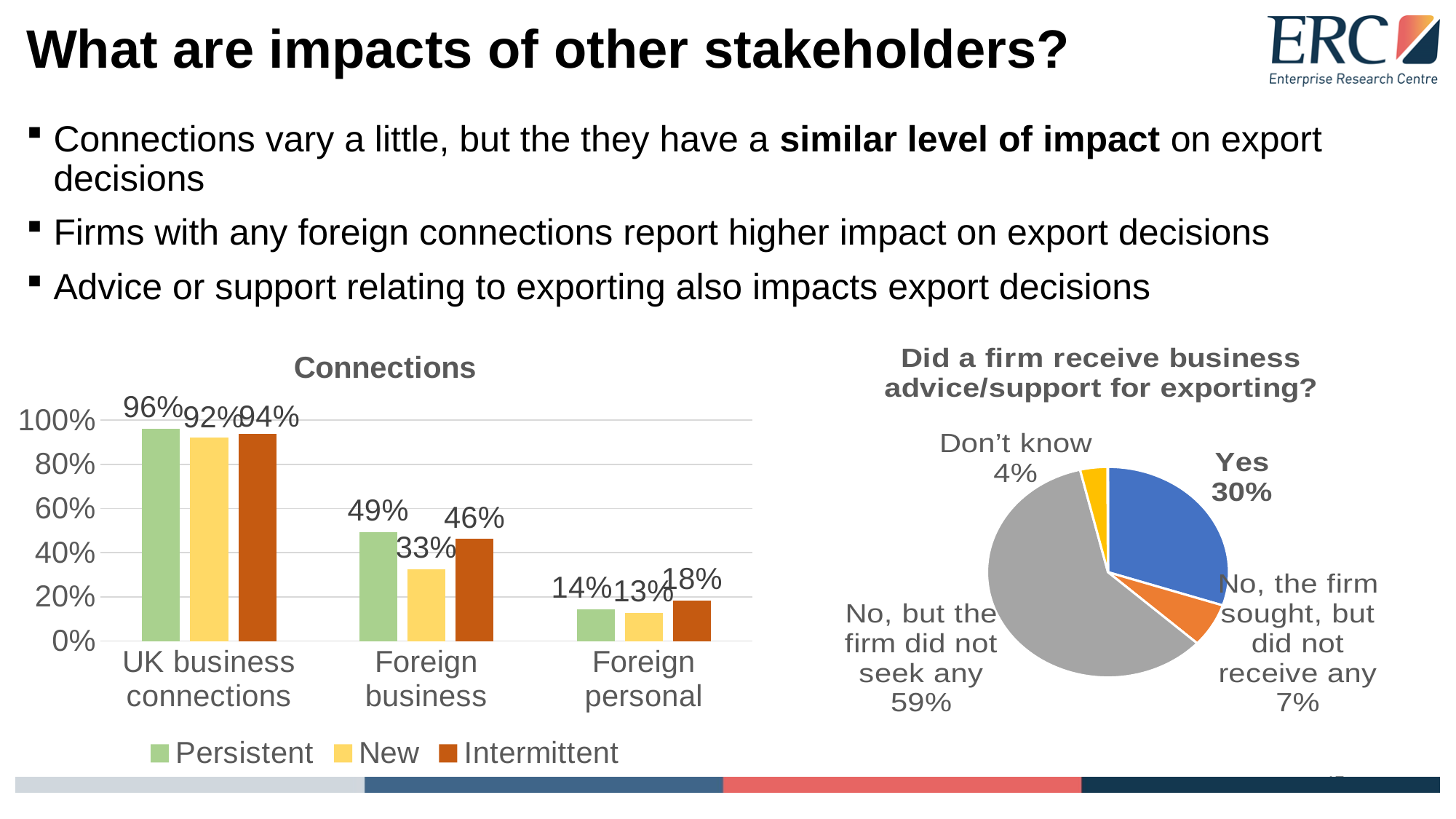
In the pie chart 'Did a firm receive business advice/support for exporting?', what share of firms answered 'Yes'? 30% How many categories are shown on the x axis of the 'Connections' chart? 3 How many series does the legend of the 'Connections' chart list? 3 In the 'Connections' chart, what is the difference between the Persistent and New values for Foreign business connections? 16% In the 'Connections' chart, what is the value for Persistent exporters with UK business connections? 96% In the 'Connections' chart, what is the value for Intermittent exporters with Foreign personal connections? 18% In the pie chart 'Did a firm receive business advice/support for exporting?', what is the difference between the 'No, the firm sought, but did not receive any' share and the 'Don't know' share? 3% What kind of chart is the 'Connections' chart? Bar chart In the 'Connections' chart, which is larger for Foreign business connections: Persistent or Intermittent? Persistent In the 'Connections' chart, which category has the lowest value for the Persistent series? Foreign personal In the pie chart 'Did a firm receive business advice/support for exporting?', which response has the largest share? No, but the firm did not seek any In the 'Connections' chart, what is the value for New exporters with Foreign business connections? 33%